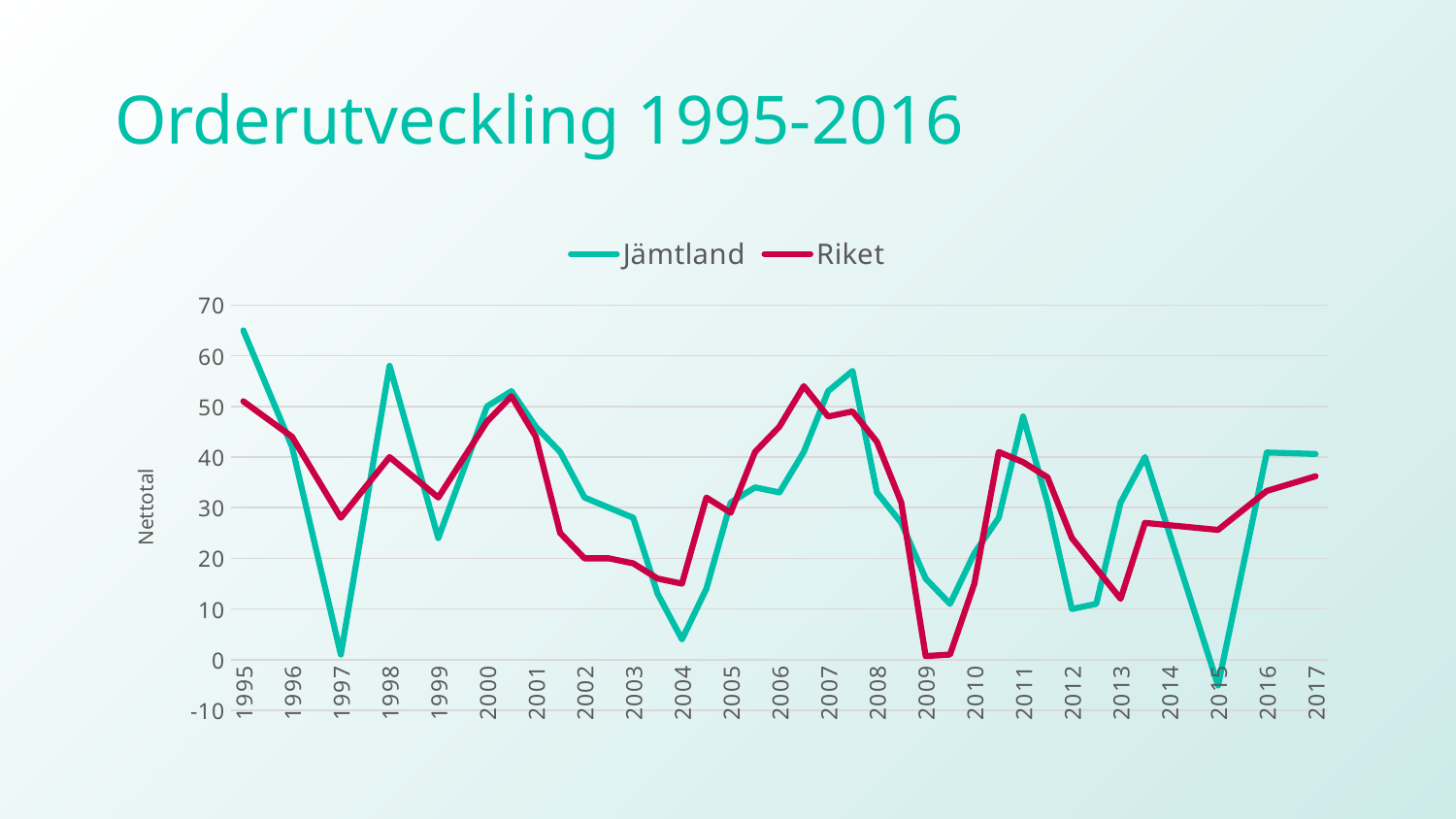
How many series does the legend list? 2 In 1995, which series has the higher value, Jämtland or Riket? Jämtland Does the Jämtland series rise or fall from 1995 to 1997? fall In 1997, which series has the higher value, Jämtland or Riket? Riket Is the value for Riket in 2009 greater or less than 10? less In which year does the Riket series reach its lowest value? 2009 What is the title of the chart? Orderutveckling 1995-2016 Is the value for Riket in 2004 greater or less than 20? less What kind of chart is shown on the slide? line chart Is the value for Jämtland in 1997 greater or less than 10? less What is the label on the vertical axis? Nettotal